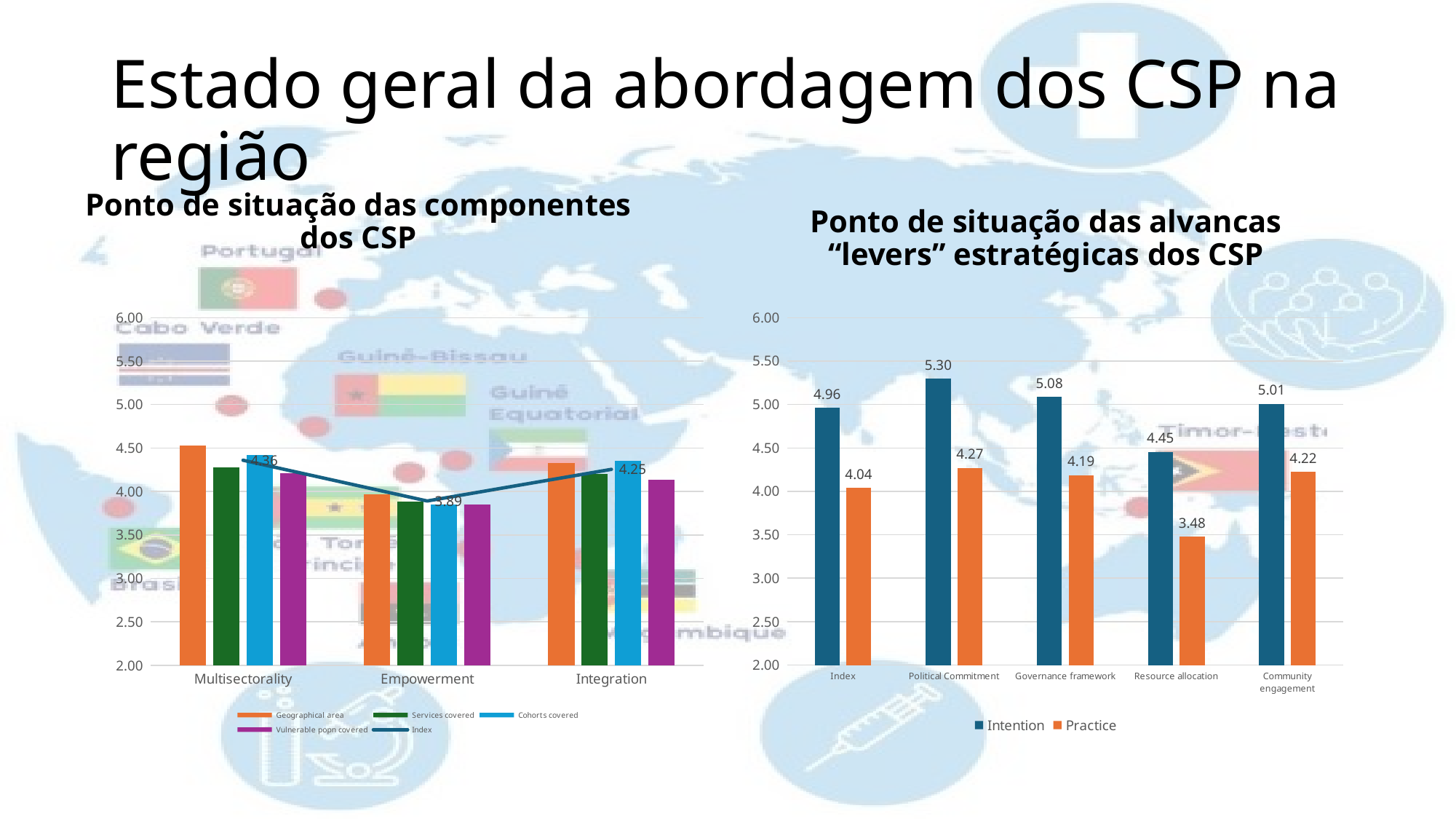
In the chart 'Ponto de situação das alvancas “levers” estratégicas dos CSP', what is the Practice value for Resource allocation? 3.48 In the chart 'Ponto de situação das alvancas “levers” estratégicas dos CSP', what is the Intention value for Political Commitment? 5.30 In the chart 'Ponto de situação das componentes dos CSP', is the Geographical area value for Empowerment greater or less than 4.50? less In the chart 'Ponto de situação das componentes dos CSP', which category has the highest Index value? Multisectorality In the chart 'Ponto de situação das alvancas “levers” estratégicas dos CSP', which category has the lowest Practice value? Resource allocation In the chart 'Ponto de situação das alvancas “levers” estratégicas dos CSP', how many categories are shown on the x axis? 5 In the chart 'Ponto de situação das componentes dos CSP', how many entries does the legend list? 5 In the chart 'Ponto de situação das alvancas “levers” estratégicas dos CSP', how many series does the legend list? 2 In the chart 'Ponto de situação das alvancas “levers” estratégicas dos CSP', which category has the highest Intention value? Political Commitment In the chart 'Ponto de situação das alvancas “levers” estratégicas dos CSP', what is the difference between the Intention and Practice values for Governance framework? 0.89 What kind of chart is 'Ponto de situação das alvancas “levers” estratégicas dos CSP'? Bar chart In the chart 'Ponto de situação das componentes dos CSP', what is the Index value for Empowerment? 3.89